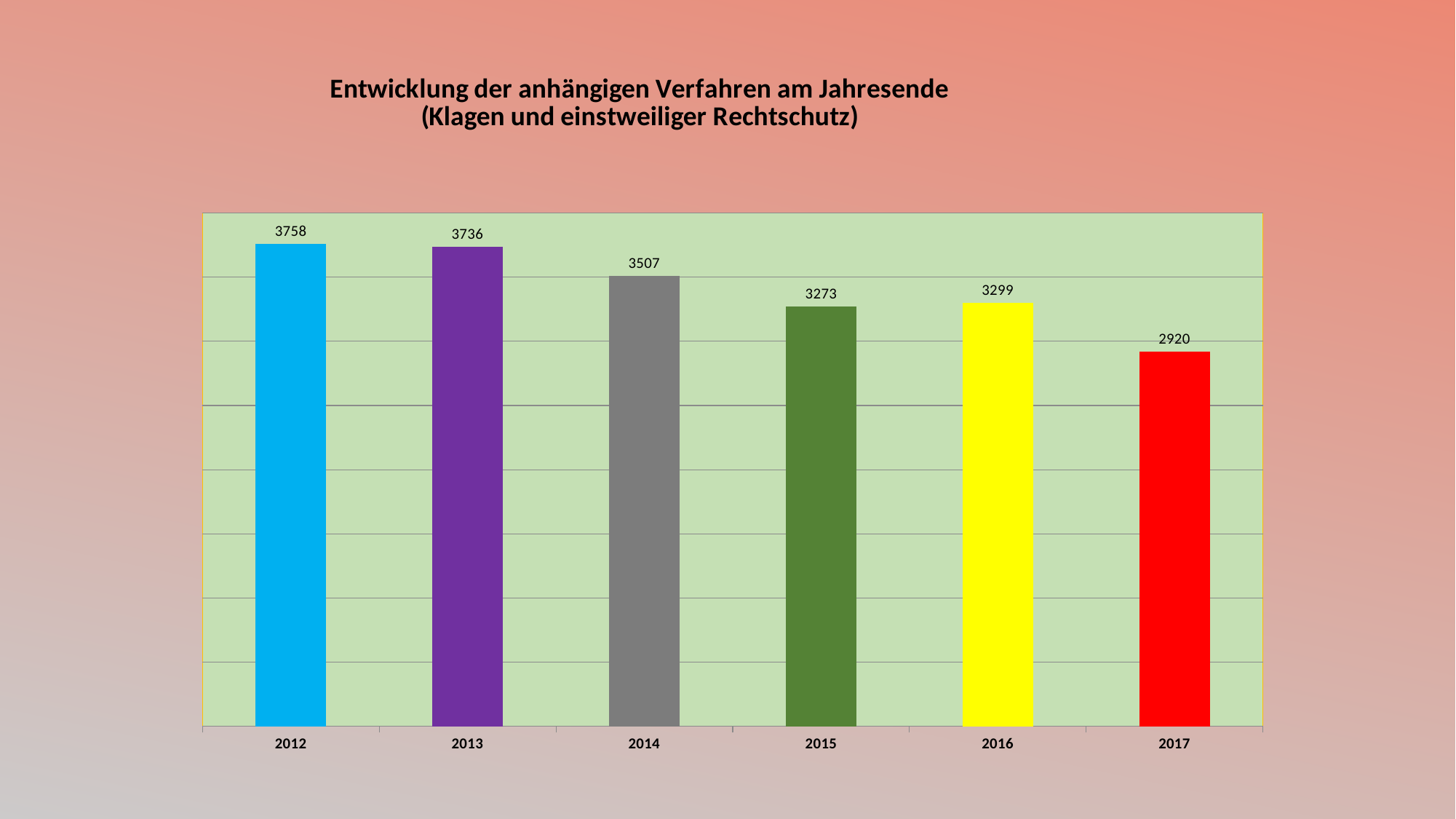
What kind of chart is this? bar chart What is the value for 2012? 3758 Do the values generally rise or fall from 2012 to 2017? fall Which year has the highest value? 2012 How many years are shown on the x axis? 6 Which is larger, the value for 2015 or the value for 2016? 2016 Which year has the lowest value? 2017 What is the value for 2015? 3273 What is the value for 2017? 2920 What is the difference between the values for 2012 and 2017? 838 What is the title of the chart? Entwicklung der anhängigen Verfahren am Jahresende (Klagen und einstweiliger Rechtschutz) What is the difference between the values for 2014 and 2015? 234